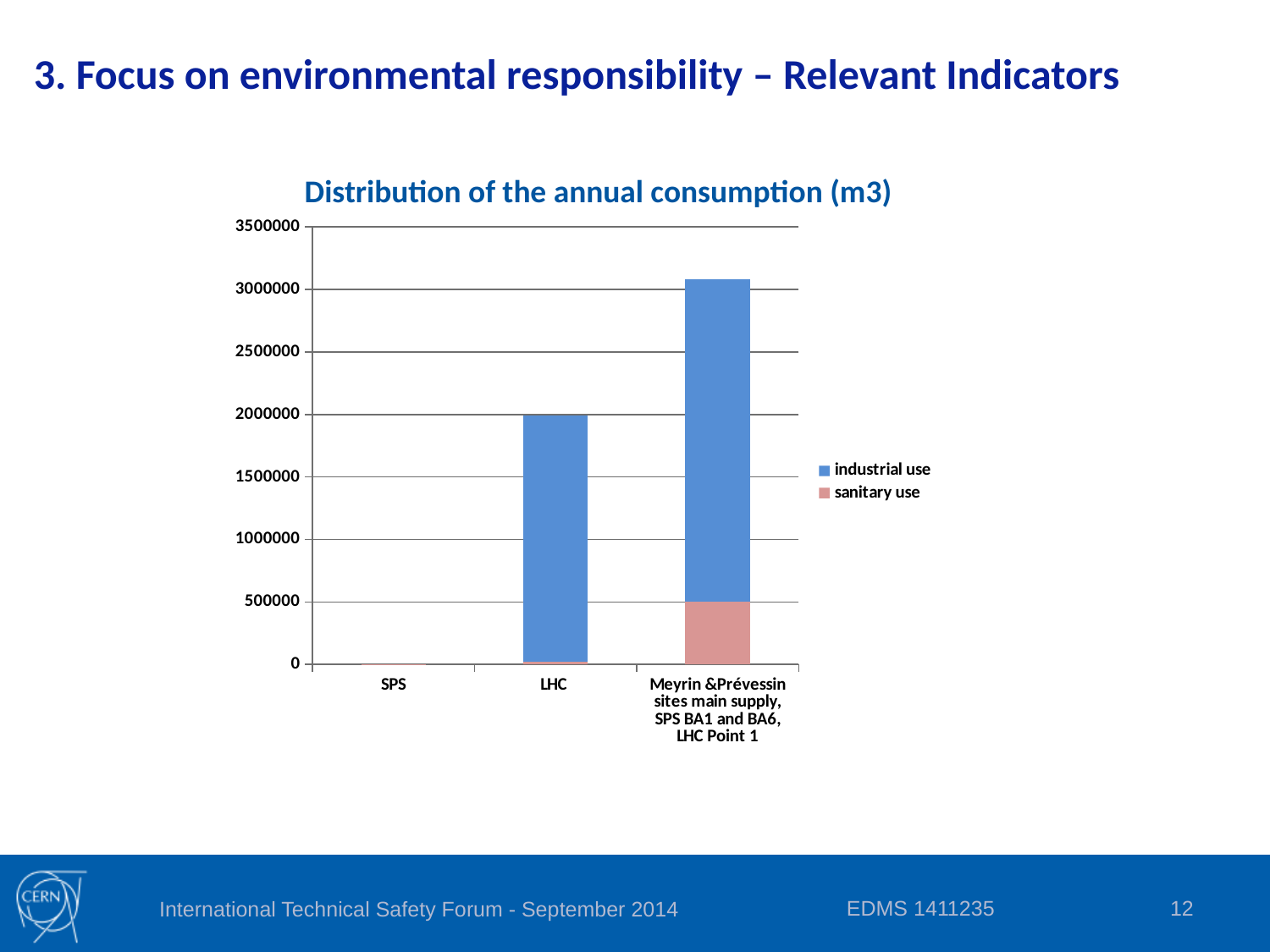
Is the total value for LHC greater or less than 2500000? less What kind of chart is shown on the slide? bar chart Which has a larger total consumption, LHC or Meyrin & Prévessin sites main supply, SPS BA1 and BA6, LHC Point 1? Meyrin & Prévessin sites main supply, SPS BA1 and BA6, LHC Point 1 How many series does the legend list? 2 Is the sanitary use value for Meyrin & Prévessin sites main supply, SPS BA1 and BA6, LHC Point 1 greater or less than 1000000? less Is the total value for Meyrin & Prévessin sites main supply, SPS BA1 and BA6, LHC Point 1 greater or less than 2500000? greater What is the title of the chart? Distribution of the annual consumption (m3) Which category has the lowest total annual consumption? SPS For Meyrin & Prévessin sites main supply, SPS BA1 and BA6, LHC Point 1, which is larger, industrial use or sanitary use? industrial use Which category has the highest total annual consumption? Meyrin & Prévessin sites main supply, SPS BA1 and BA6, LHC Point 1 How many categories are shown on the x axis? 3